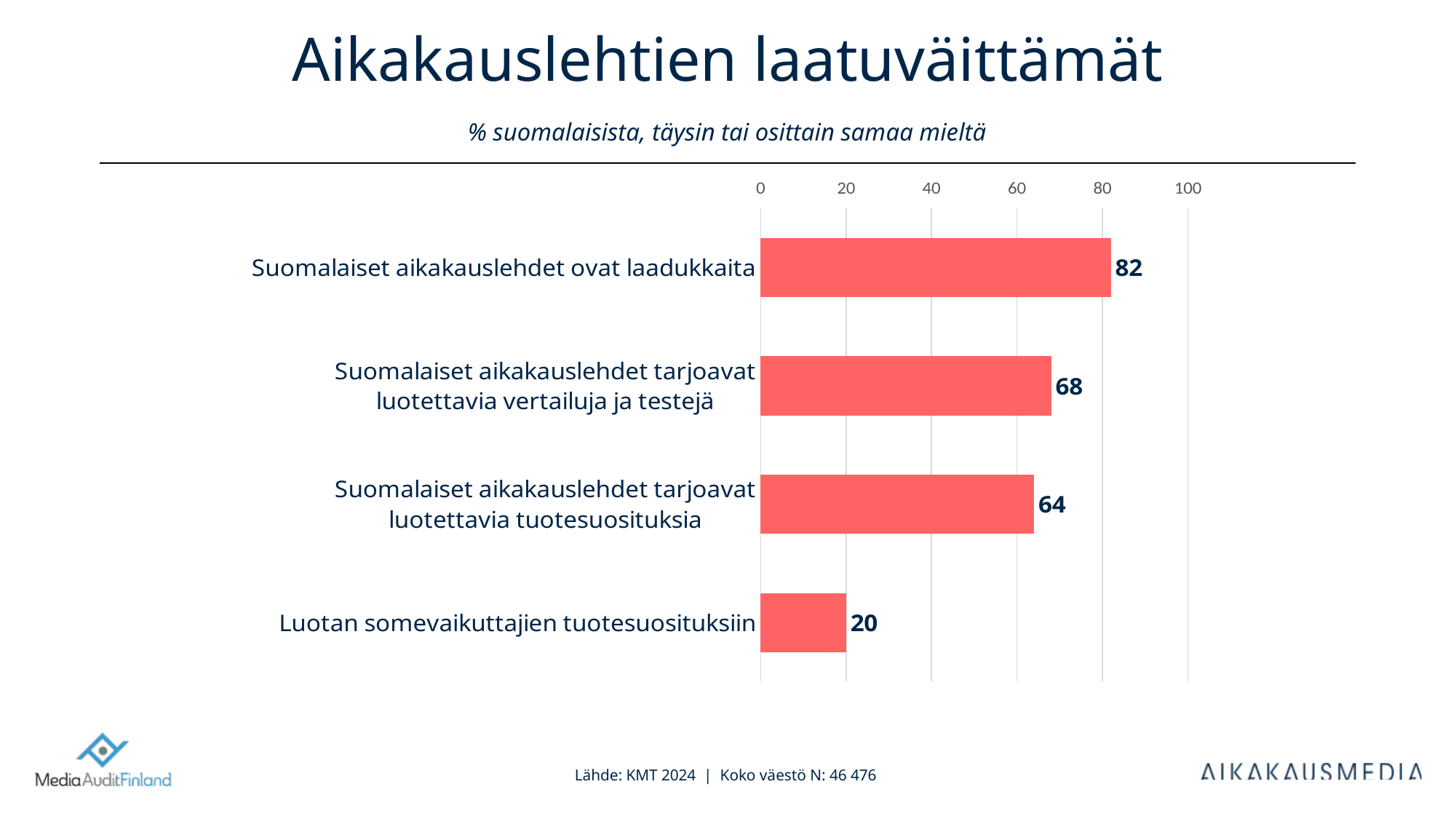
What is the value for "Suomalaiset aikakauslehdet tarjoavat luotettavia tuotesuosituksia"? 64 Which statement has the highest value? Suomalaiset aikakauslehdet ovat laadukkaita How many statements (bars) are shown in the chart? 4 Which is larger: the value for "Suomalaiset aikakauslehdet tarjoavat luotettavia tuotesuosituksia" or the value for "Luotan somevaikuttajien tuotesuosituksiin"? Suomalaiset aikakauslehdet tarjoavat luotettavia tuotesuosituksia What is the value for "Suomalaiset aikakauslehdet ovat laadukkaita"? 82 What is the value for "Luotan somevaikuttajien tuotesuosituksiin"? 20 What is the value for "Suomalaiset aikakauslehdet tarjoavat luotettavia vertailuja ja testejä"? 68 What is the title of the chart? Aikakauslehtien laatuväittämät What is the difference between the values for "Suomalaiset aikakauslehdet tarjoavat luotettavia vertailuja ja testejä" and "Suomalaiset aikakauslehdet tarjoavat luotettavia tuotesuosituksia"? 4 What is the difference between the values for "Suomalaiset aikakauslehdet ovat laadukkaita" and "Luotan somevaikuttajien tuotesuosituksiin"? 62 Which statement has the lowest value? Luotan somevaikuttajien tuotesuosituksiin What kind of chart is shown on the slide? Bar chart